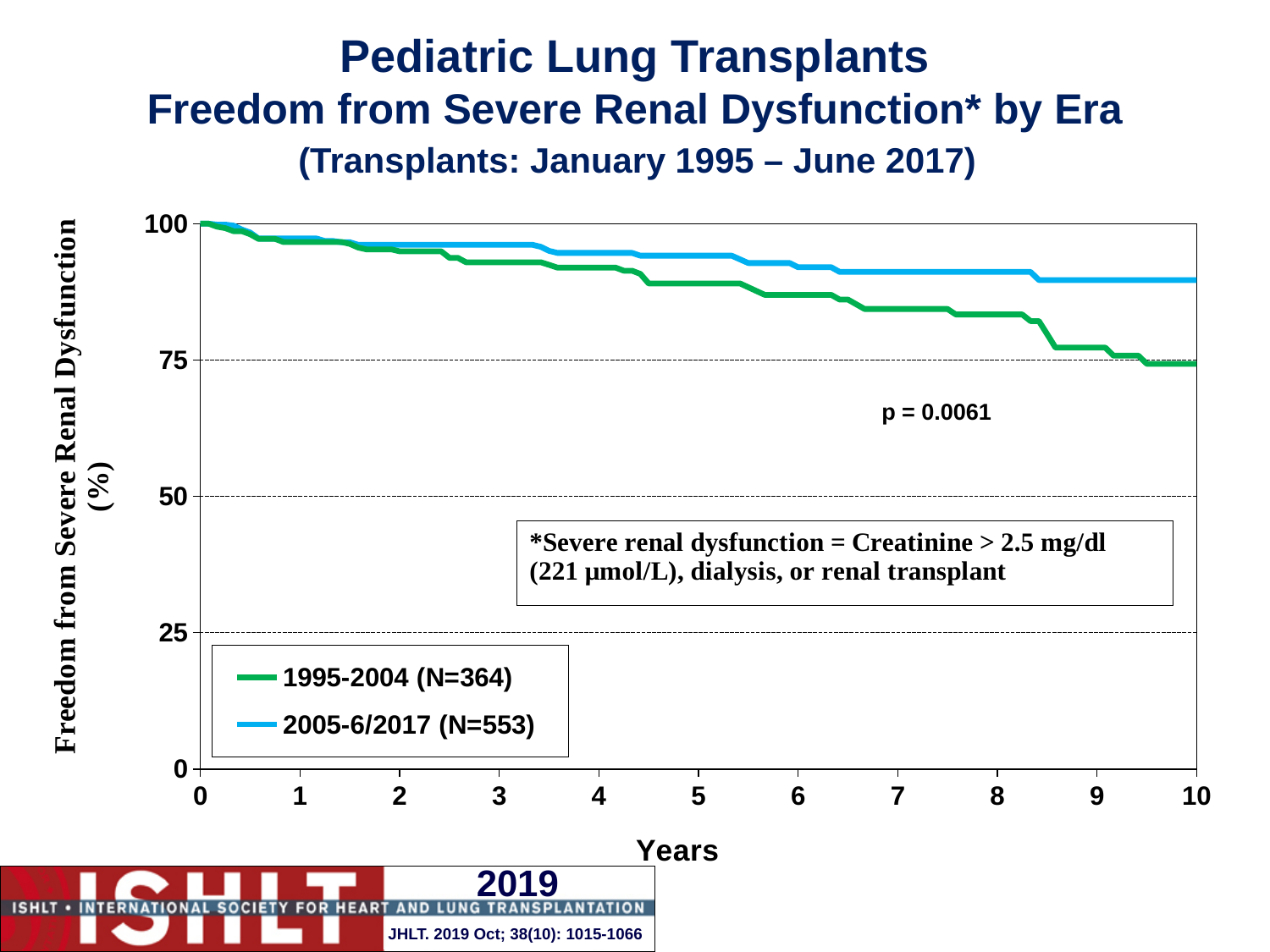
What is the value of both curves at year 0? 100 Do the curves rise or fall as years increase? fall What is the N for the 2005-6/2017 era in the legend? 553 Which era has the higher freedom from severe renal dysfunction at 10 years, 1995-2004 or 2005-6/2017? 2005-6/2017 Is the value for the 1995-2004 era at 10 years greater or less than 50? greater What kind of chart is shown on the slide? line chart Is the value for the 1995-2004 era at 5 years greater or less than 75? greater What is the p-value shown on the chart? p = 0.0061 Is the value for the 2005-6/2017 era at 10 years greater or less than 75? greater How many series does the legend list? 2 Which era has the lower freedom from severe renal dysfunction at 8 years? 1995-2004 What is the maximum value shown on the x axis (Years)? 10